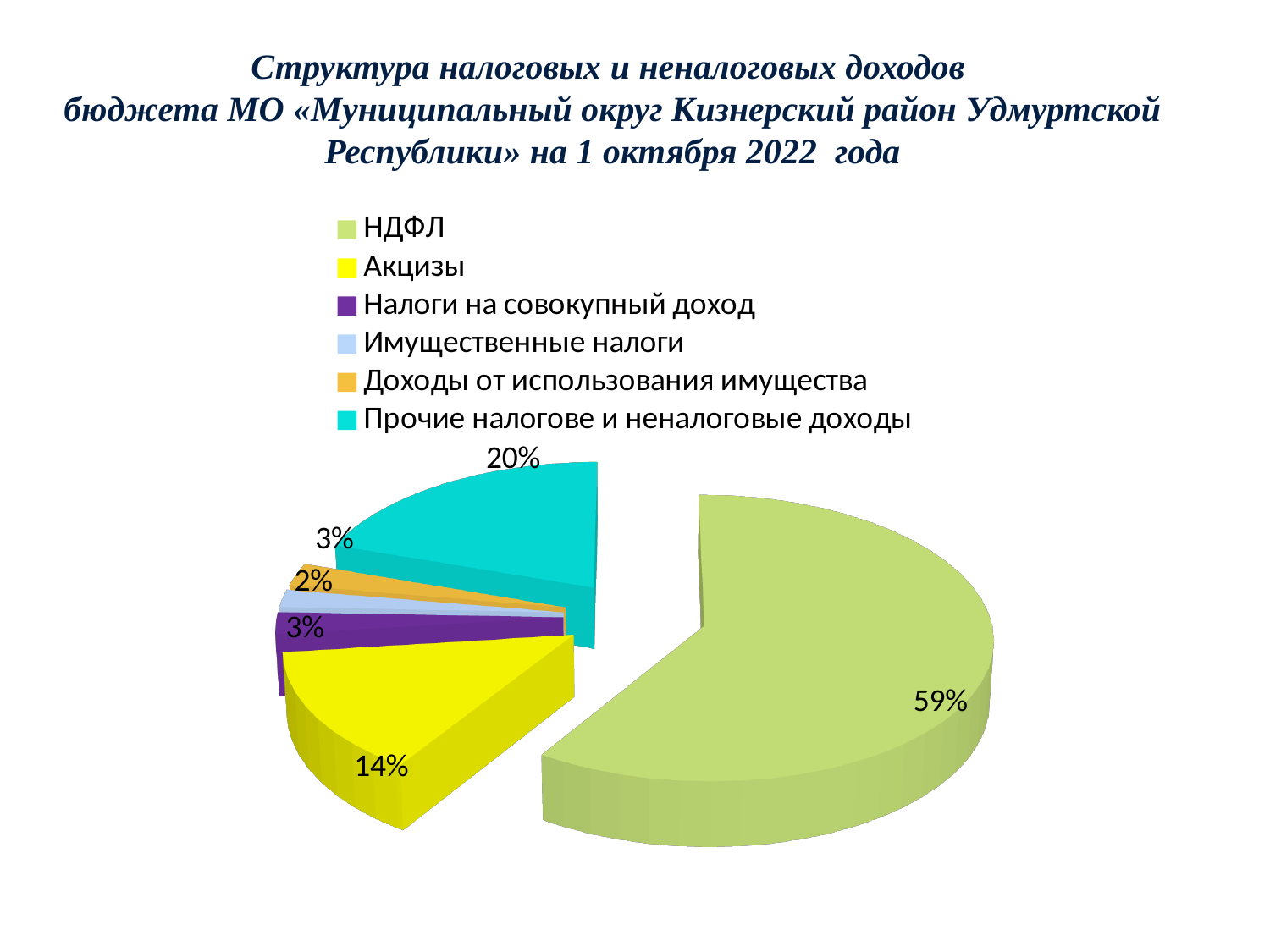
What kind of chart is shown on the slide? Pie chart Which category has the largest slice of the pie? НДФЛ What is the value shown for Прочие налогове и неналоговые доходы? 20% What is the value shown for Имущественные налоги? 2% How many slices does the pie chart have? 6 Which is larger, the share of Акцизы or the share of Прочие налогове и неналоговые доходы? Прочие налогове и неналоговые доходы What share of the pie does НДФЛ account for? 59% What colour is the slice for Акцизы? Yellow What is the value shown for Акцизы? 14% What is the difference between the shares of НДФЛ and Акцизы? 45% What is the value shown for Налоги на совокупный доход? 3% Which category has the smallest slice of the pie? Имущественные налоги